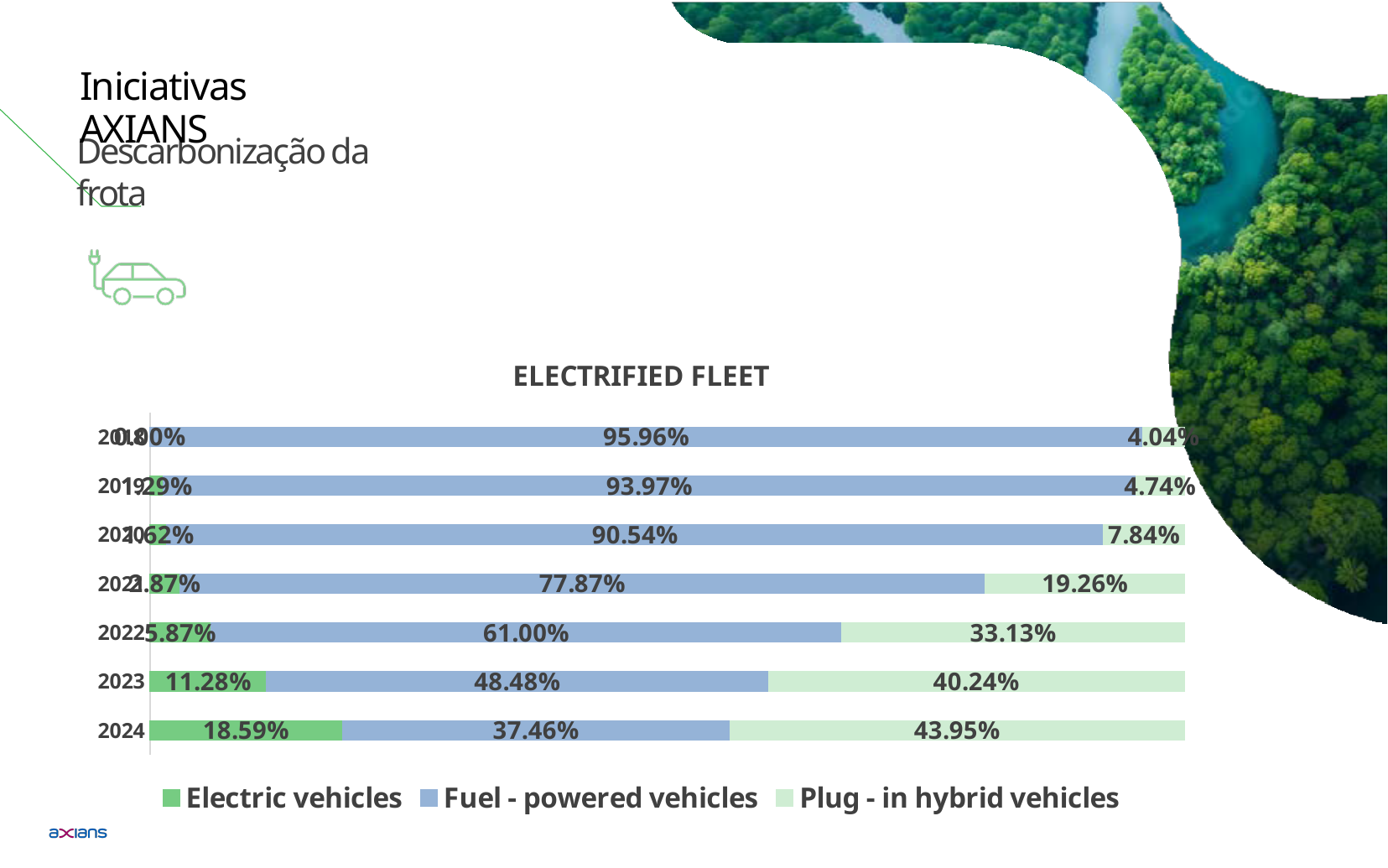
In which year is the share of plug-in hybrid vehicles lowest? 2018 By how many percentage points did the plug-in hybrid share increase from 2023 to 2024? 3.71% What is the share of fuel-powered vehicles in 2024? 37.46% How many years are shown on the ELECTRIFIED FLEET chart? 7 In 2024, which is larger: the share of fuel-powered vehicles or the share of plug-in hybrid vehicles? Plug-in hybrid vehicles In which year is the share of fuel-powered vehicles highest? 2018 What is the share of plug-in hybrid vehicles in 2021? 19.26% What is the title of the chart on the slide? ELECTRIFIED FLEET What is the share of electric vehicles in 2024? 18.59% What kind of chart is shown under the title ELECTRIFIED FLEET? Bar chart How many series does the legend of the ELECTRIFIED FLEET chart list? 3 Does the share of fuel-powered vehicles rise or fall from 2018 to 2024? Fall